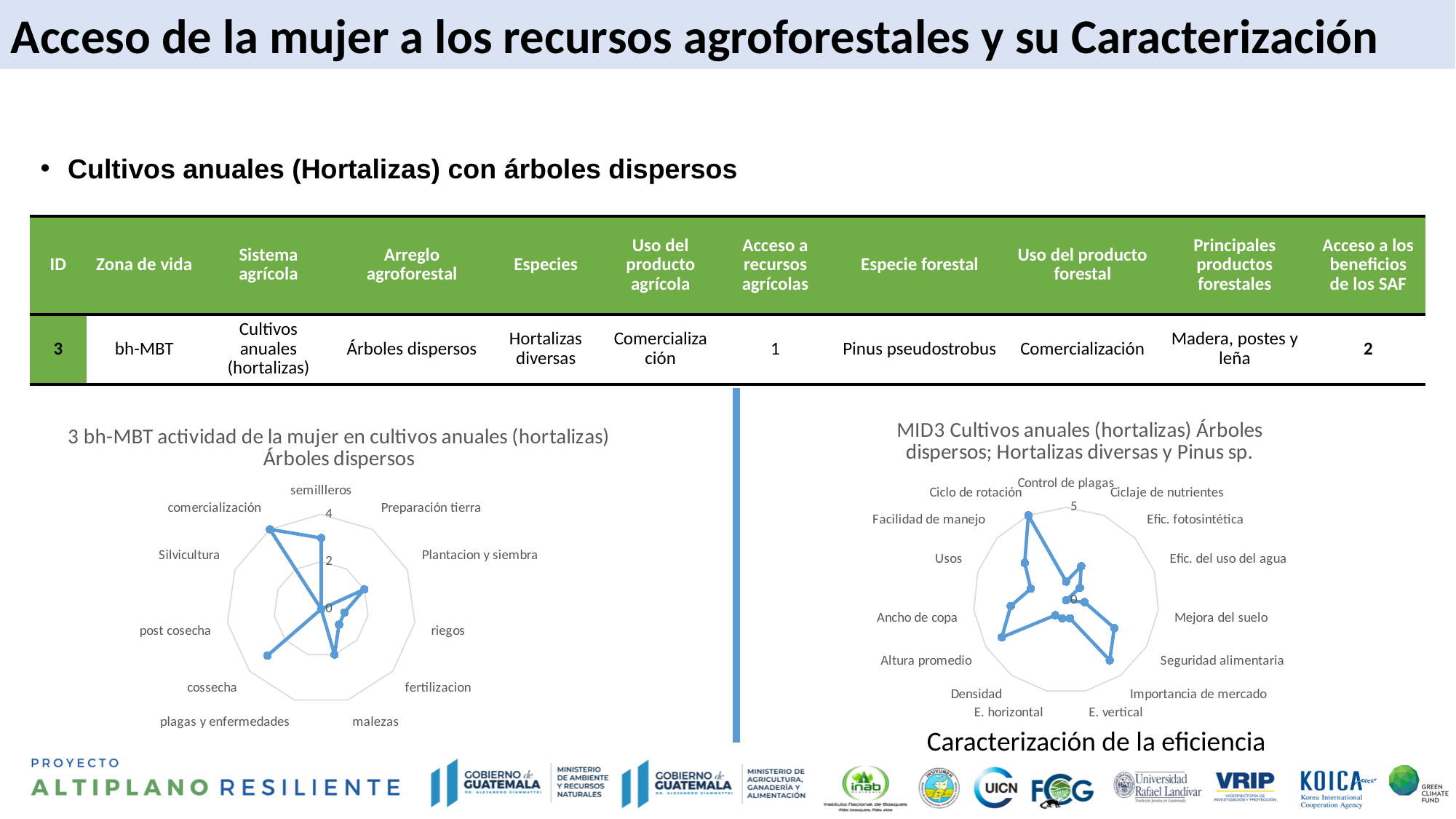
What is the maximum axis tick value shown on the right chart (MID3 Cultivos anuales)? 5 In the left chart (3 bh-MBT actividad de la mujer), is the value for comercialización greater or less than 2? greater What kind of chart is the right chart titled 'MID3 Cultivos anuales (hortalizas) Árboles dispersos; Hortalizas diversas y Pinus sp.'? Radar chart In the right chart (MID3 Cultivos anuales), which is larger, the value for Ciclo de rotación or the value for Usos? Ciclo de rotación In the right chart (MID3 Cultivos anuales), how many categories are plotted around the radar? 15 What kind of chart is the left chart titled '3 bh-MBT actividad de la mujer en cultivos anuales (hortalizas) Árboles dispersos'? Radar chart In the right chart (MID3 Cultivos anuales), which category has the highest value? Ciclo de rotación In the left chart (3 bh-MBT actividad de la mujer), how many categories are plotted around the radar? 11 In the left chart (3 bh-MBT actividad de la mujer), is the value for post cosecha greater or less than 2? less In the left chart (3 bh-MBT actividad de la mujer), which is larger, the value for comercialización or the value for Silvicultura? comercialización In the left chart (3 bh-MBT actividad de la mujer), is the value for Silvicultura greater or less than 2? less In the left chart (3 bh-MBT actividad de la mujer), which category has the highest value? comercialización